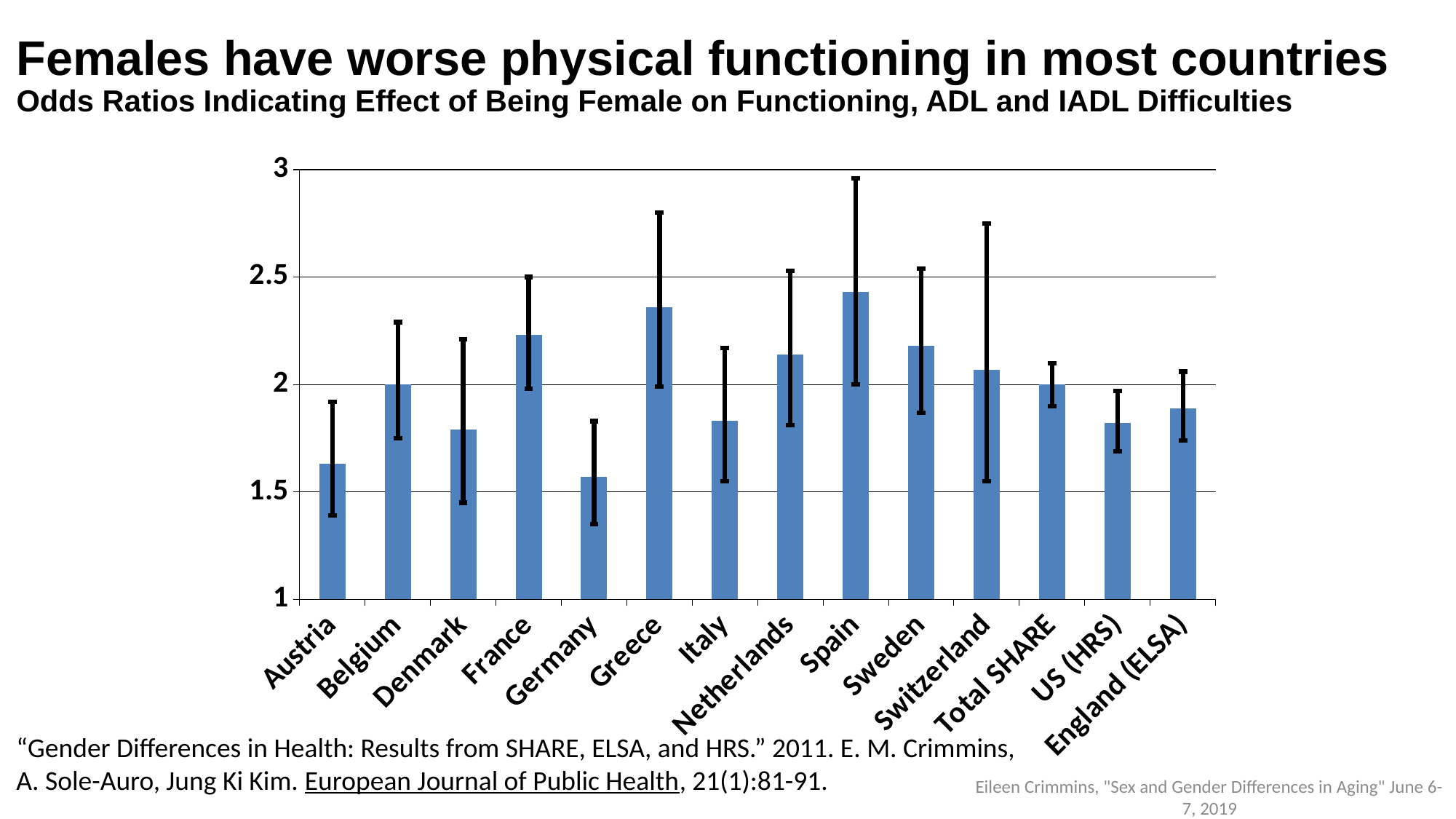
Which is larger, the value for Greece or the value for Italy? Greece Which is larger, the value for France or the value for Denmark? France How many categories are plotted along the x axis? 14 Is the value for Austria greater or less than 2? less Which category has the lowest odds ratio? Germany Is the value for Italy greater or less than 2? less What is the subtitle of the chart describing what the bars represent? Odds Ratios Indicating Effect of Being Female on Functioning, ADL and IADL Difficulties Is the value for Greece greater or less than 2? greater Which category has the highest odds ratio? Spain What is the lowest value shown on the y axis? 1 What kind of chart is shown on the slide? bar chart